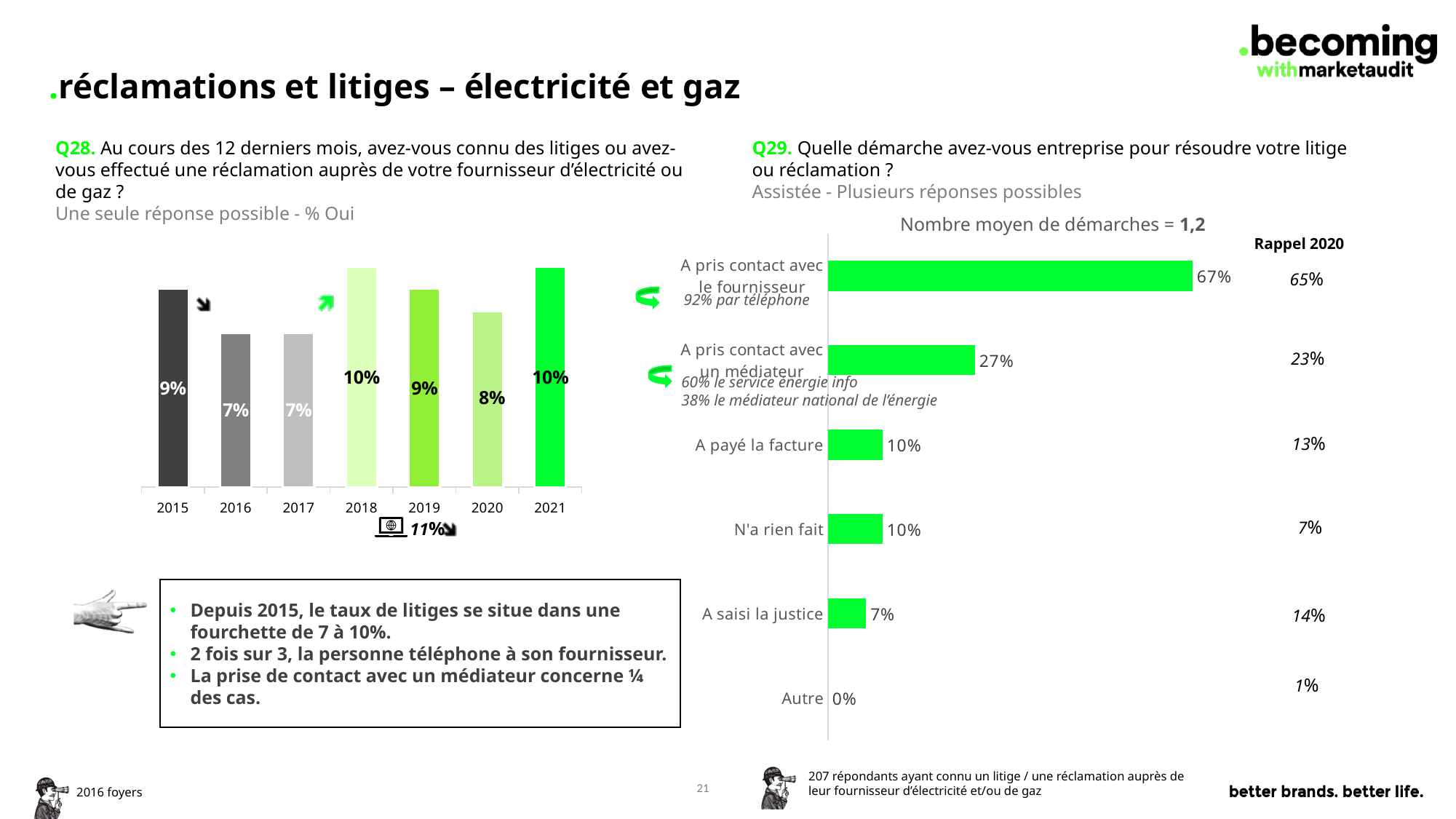
What kind of chart is the Q28 chart on the left? Bar chart How many categories are shown in the Q29 chart on the right? 6 In the Q29 chart on the right, what is the difference between 'A pris contact avec le fournisseur' and 'A pris contact avec un médiateur'? 40% In the Q28 chart on the left, what is the difference between the values for 2018 and 2020? 2% In the Q29 chart on the right, which category has the lowest value? Autre In the Q28 chart on the left, what is the value for 2016? 7% In the Q29 chart on the right, which category has the highest value? A pris contact avec le fournisseur In the Q29 chart on the right, what is the value for 'A pris contact avec le fournisseur'? 67% In the Q29 chart on the right, what is the value for 'A saisi la justice'? 7% How many years are shown in the Q28 chart on the left? 7 In the Q28 chart on the left, which is larger, the value for 2015 or the value for 2017? 2015 In the Q28 chart on the left, what is the value for 2021? 10%